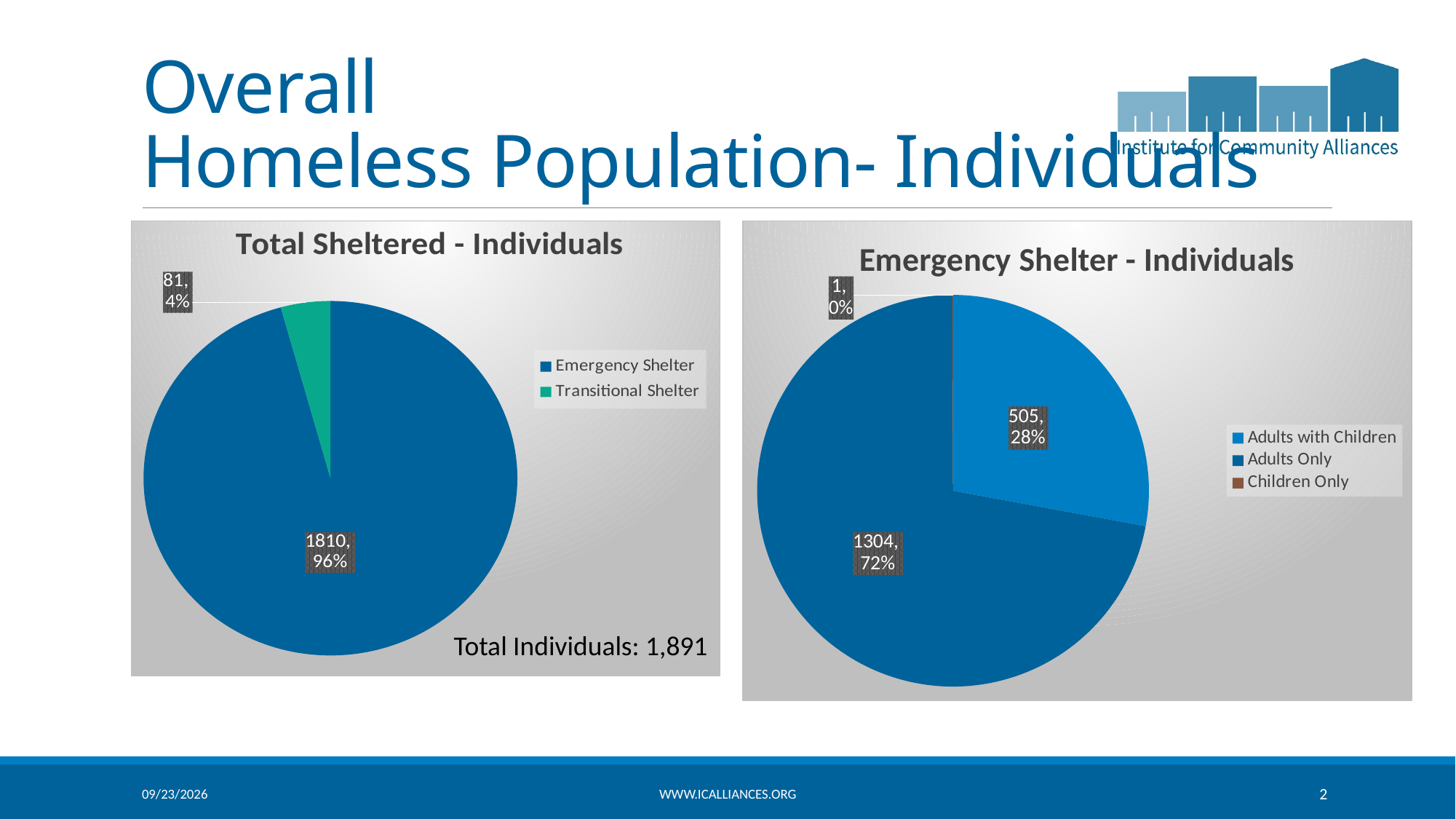
In the 'Total Sheltered - Individuals' chart, what is the value for Transitional Shelter? 81 In the 'Emergency Shelter - Individuals' chart, what is the value for Adults Only? 1304 What kind of chart is the 'Total Sheltered - Individuals' chart? Pie chart In the 'Total Sheltered - Individuals' chart, what total number of individuals is stated? 1,891 In the 'Total Sheltered - Individuals' chart, what share of the pie is Transitional Shelter? 4% How many categories does the legend of the 'Emergency Shelter - Individuals' chart list? 3 In the 'Emergency Shelter - Individuals' chart, what share of the pie is Adults Only? 72% In the 'Emergency Shelter - Individuals' chart, what is the value for Adults with Children? 505 In the 'Total Sheltered - Individuals' chart, what is the value for Emergency Shelter? 1810 In the 'Total Sheltered - Individuals' chart, what is the difference between the Emergency Shelter and Transitional Shelter values? 1729 In the 'Emergency Shelter - Individuals' chart, which category has the highest value? Adults Only In the 'Emergency Shelter - Individuals' chart, which category has the lowest value? Children Only